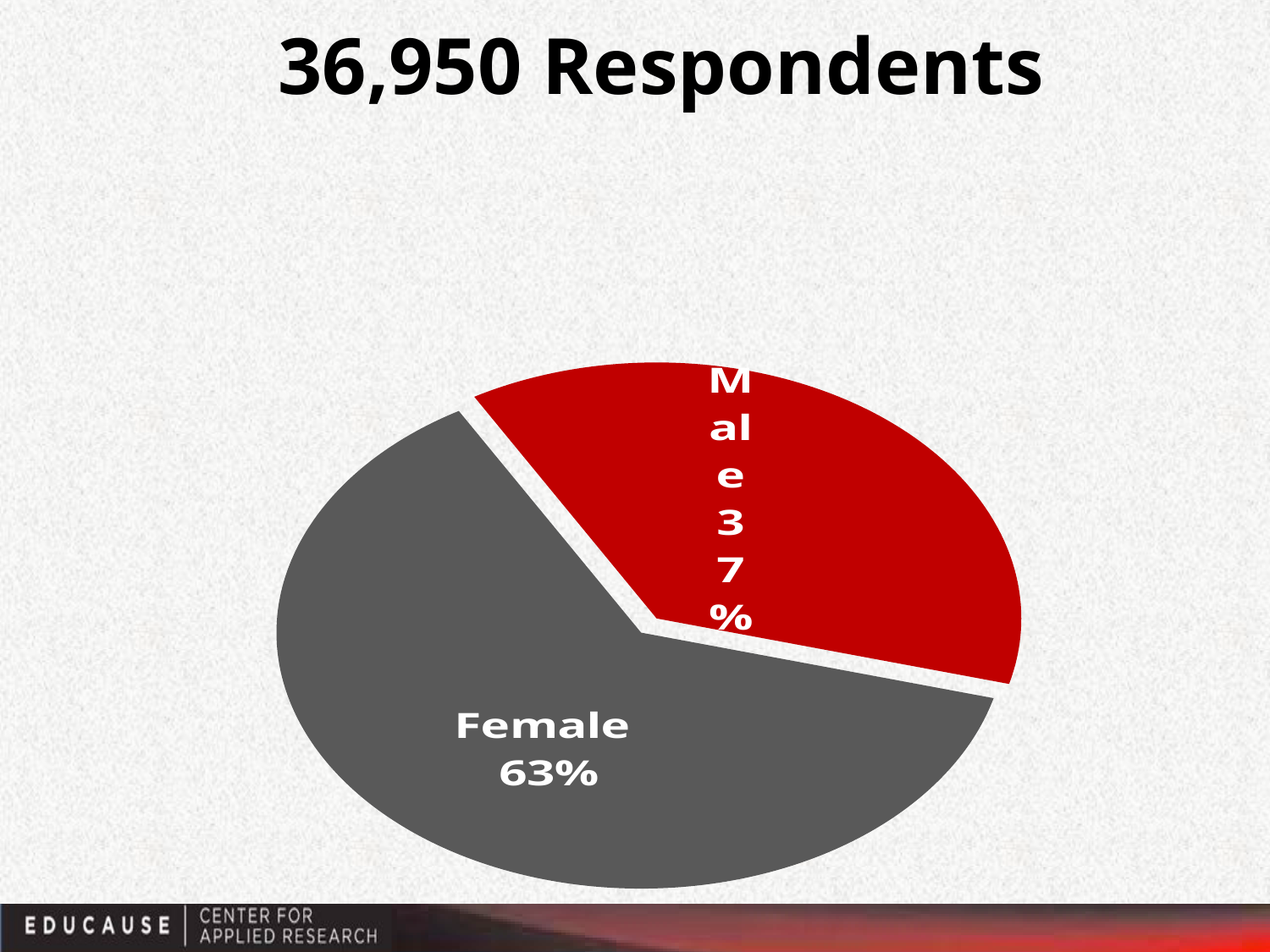
What colour is the Male slice of the pie? red What share of respondents are male? 37% Which slice of the pie is the smallest? Male What is the difference in percentage points between the Female and Male slices? 26 Which slice of the pie is the largest? Female What kind of chart is shown on the slide? pie chart How many slices does the pie chart have? 2 What share of respondents are female? 63% What is the title of the slide above the pie chart? 36,950 Respondents Which is larger, the Female slice or the Male slice? Female Is the Male share greater or less than 50%? less